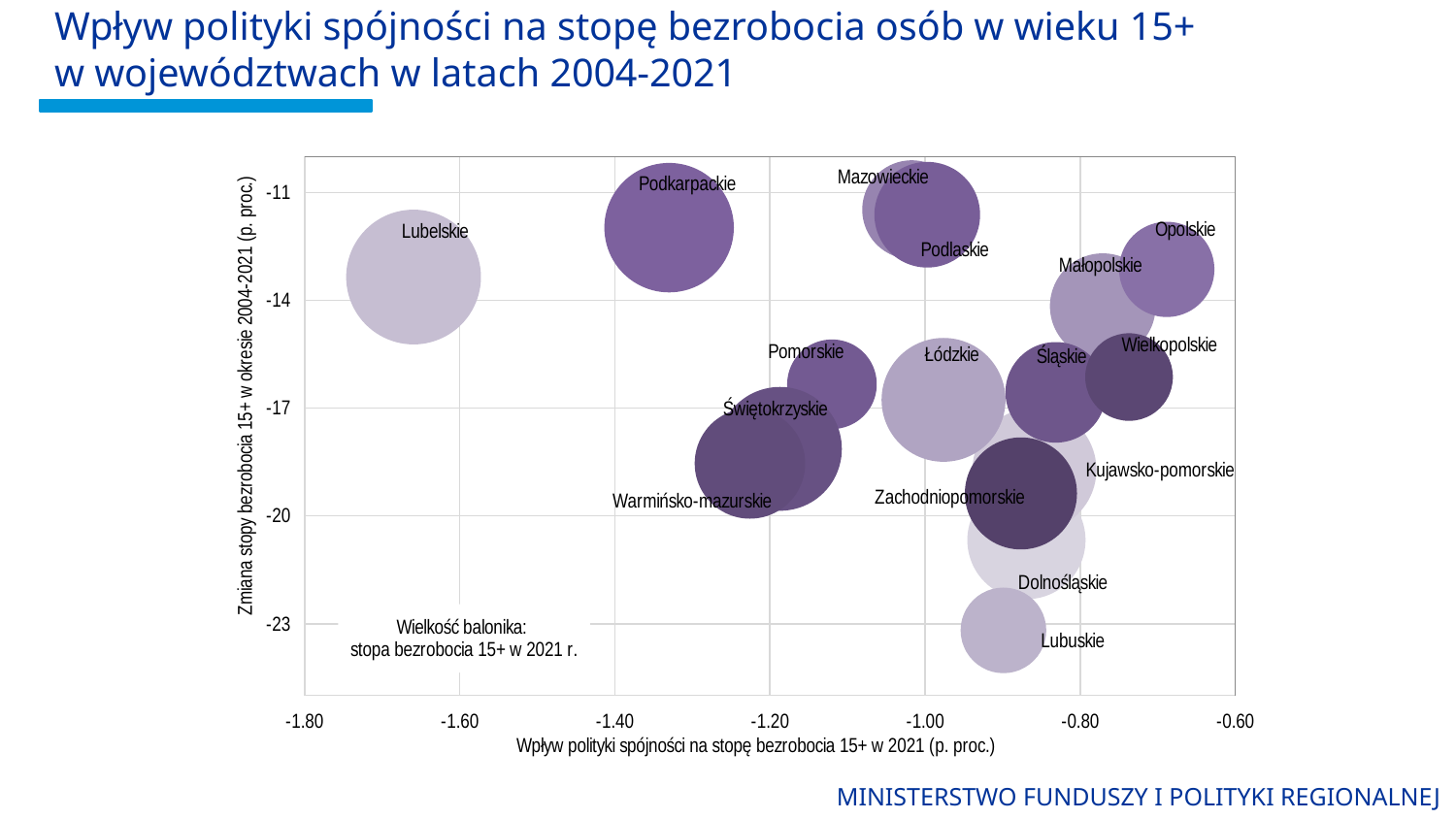
According to the note on the chart, what does the size of a bubble represent? stopa bezrobocia 15+ w 2021 r. Which has the larger horizontal-axis value, Lubelskie or Opolskie? Opolskie Which voivodeship has the lowest (most negative) value on the horizontal axis? Lubelskie Which voivodeship has the lowest (most negative) change in the unemployment rate on the vertical axis? Lubuskie Is the vertical-axis value for Lubelskie greater or less than -17? greater Is the vertical-axis value for Podkarpackie greater or less than -14? greater Which has the larger vertical-axis value, Podkarpackie or Lubuskie? Podkarpackie What kind of chart is shown on the slide? bubble chart Is the horizontal-axis value for Opolskie greater or less than -0.80? greater How many voivodeships (bubbles) are plotted on the chart? 16